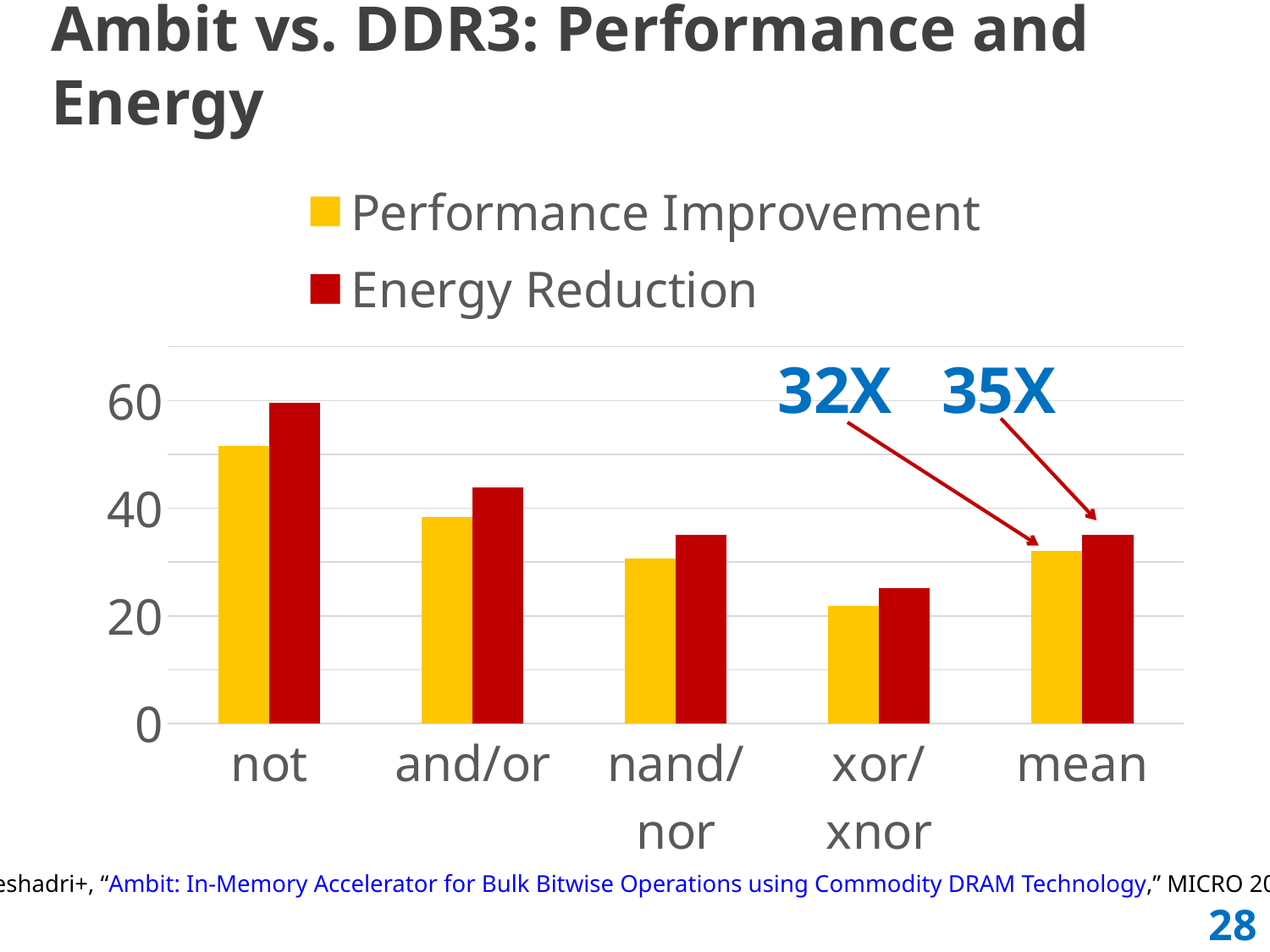
Which category has the lowest Energy Reduction? xor/xnor How many categories are shown on the x axis? 5 What kind of chart is shown on the slide? bar chart How many series does the legend list? 2 Which category has the highest Performance Improvement? not What is the Energy Reduction value for the mean category? 35X By how much does the mean Energy Reduction exceed the mean Performance Improvement? 3X Is the Energy Reduction value for xor/xnor greater or less than 40? less Is the Energy Reduction value for not greater or less than 40? greater What is the Performance Improvement value for the mean category? 32X Does the Performance Improvement rise or fall from not to xor/xnor? fall Which has the larger Energy Reduction, not or and/or? not